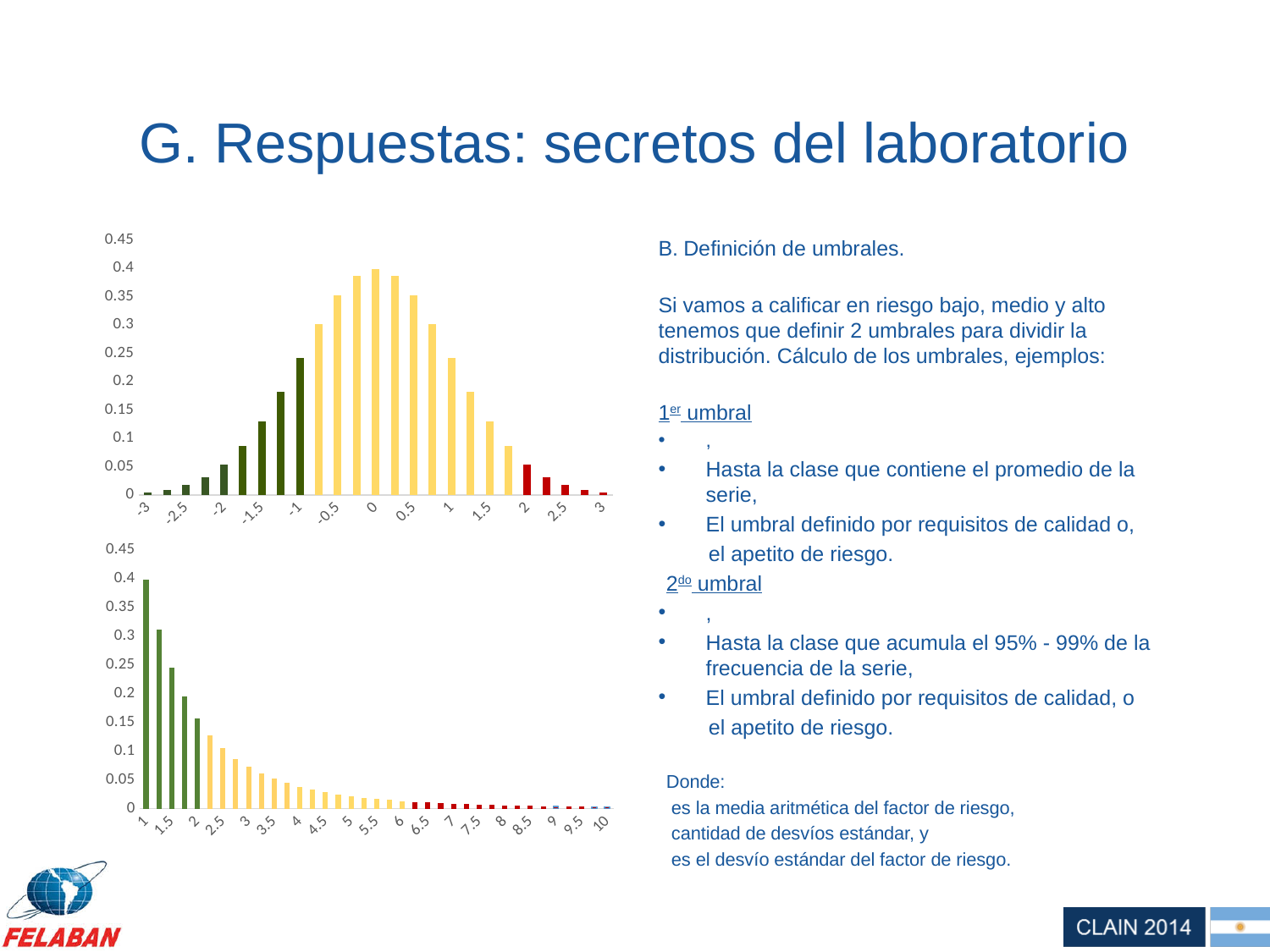
In the top chart, is the value for -1 greater or less than 0.2? greater In the bottom chart, is the value for 5 greater or less than 0.05? less In the top chart, which has the larger value, 0 or 1? 0 What kind of chart is the top chart on the slide? bar chart In the top chart, which x-axis category has the tallest bar? 0 In the top chart, is the value for -0.5 greater or less than 0.3? greater In the bottom chart, which x-axis category has the tallest bar? 1 What is the highest value shown on the y axis of the bottom chart? 0.45 In the bottom chart, do the bar values rise or fall as you move from left to right along the x axis? fall